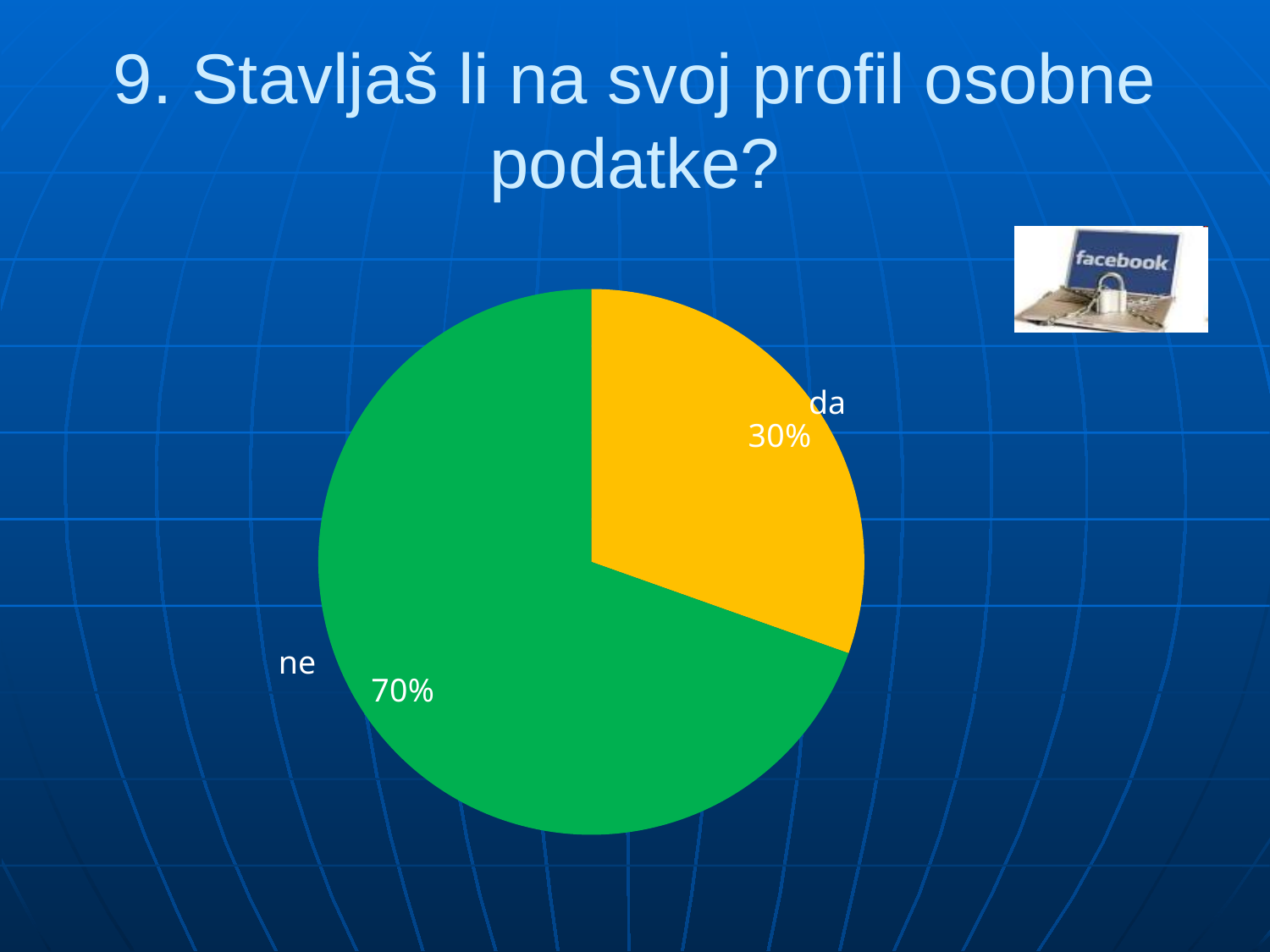
What colour is the "ne" slice of the pie? green Which is larger, the "da" slice or the "ne" slice? ne What kind of chart is shown on the slide? pie chart What colour is the "da" slice of the pie? yellow What percentage of the pie is labelled "ne"? 70% Which slice of the pie is the smallest? da How many slices does the pie chart have? 2 What is the difference in percentage points between the "ne" slice and the "da" slice? 40 What share of the pie does the "da" slice take? 30% What percentage of the pie is labelled "da"? 30% Which slice of the pie is the largest? ne